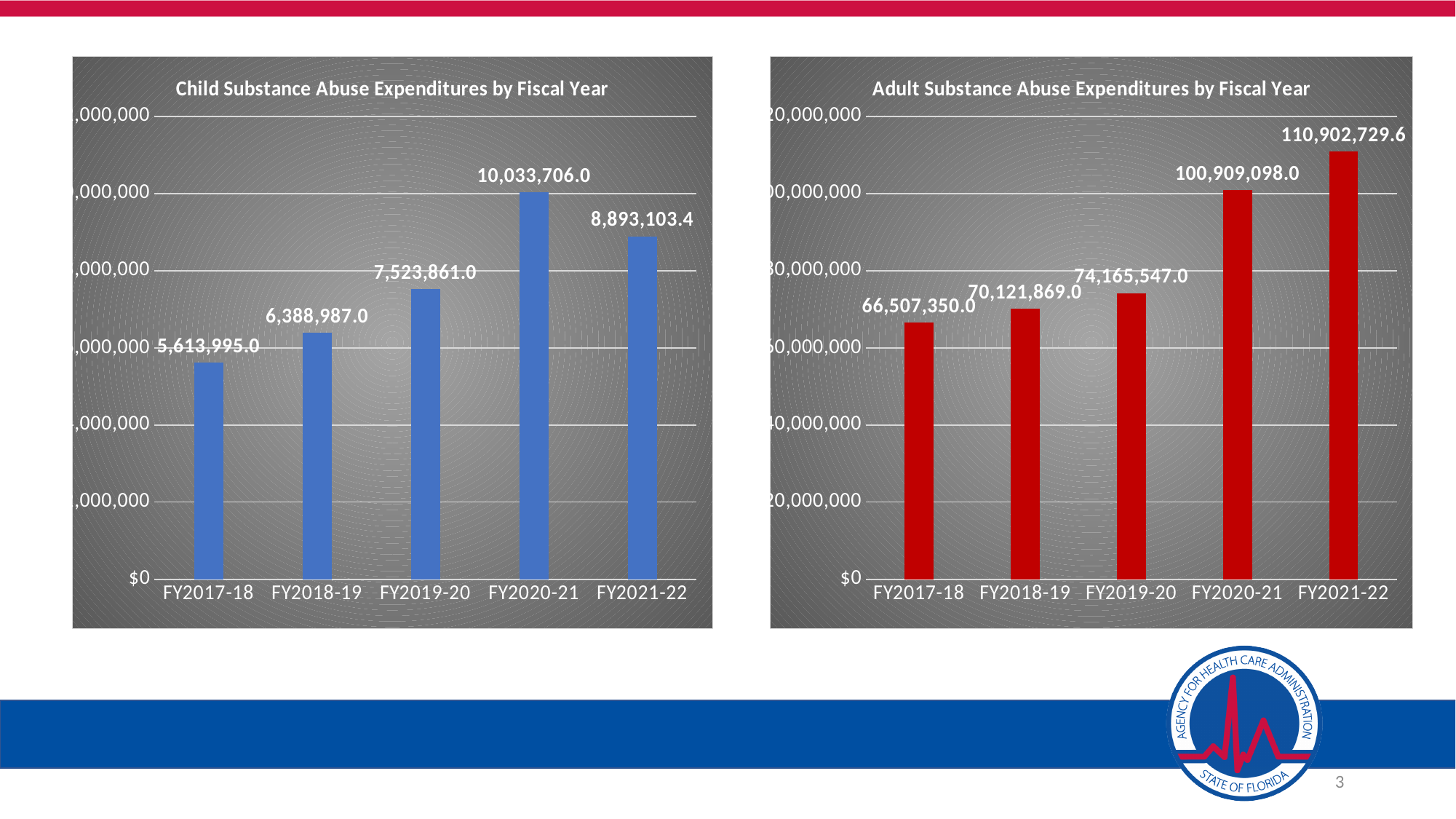
How many fiscal years are shown in the Adult Substance Abuse Expenditures by Fiscal Year chart? 5 In the Child Substance Abuse Expenditures by Fiscal Year chart, what is the value for FY2017-18? 5,613,995.0 In the Adult Substance Abuse Expenditures by Fiscal Year chart, is the value for FY2019-20 greater or less than 80,000,000? less In the Child Substance Abuse Expenditures by Fiscal Year chart, which fiscal year has the highest expenditure? FY2020-21 In the Adult Substance Abuse Expenditures by Fiscal Year chart, which fiscal year has the lowest expenditure? FY2017-18 In the Adult Substance Abuse Expenditures by Fiscal Year chart, what is the value for FY2021-22? 110,902,729.6 In the Child Substance Abuse Expenditures by Fiscal Year chart, what is the value for FY2020-21? 10,033,706.0 In the Adult Substance Abuse Expenditures by Fiscal Year chart, what is the difference between the FY2021-22 and FY2020-21 values? 9,993,631.6 In the Child Substance Abuse Expenditures by Fiscal Year chart, what is the difference between the FY2020-21 and FY2021-22 values? 1,140,602.6 In the Child Substance Abuse Expenditures by Fiscal Year chart, which is larger, the value for FY2019-20 or FY2021-22? FY2021-22 In the Adult Substance Abuse Expenditures by Fiscal Year chart, what is the value for FY2019-20? 74,165,547.0 In the Adult Substance Abuse Expenditures by Fiscal Year chart, do the values rise or fall from FY2017-18 to FY2021-22? rise